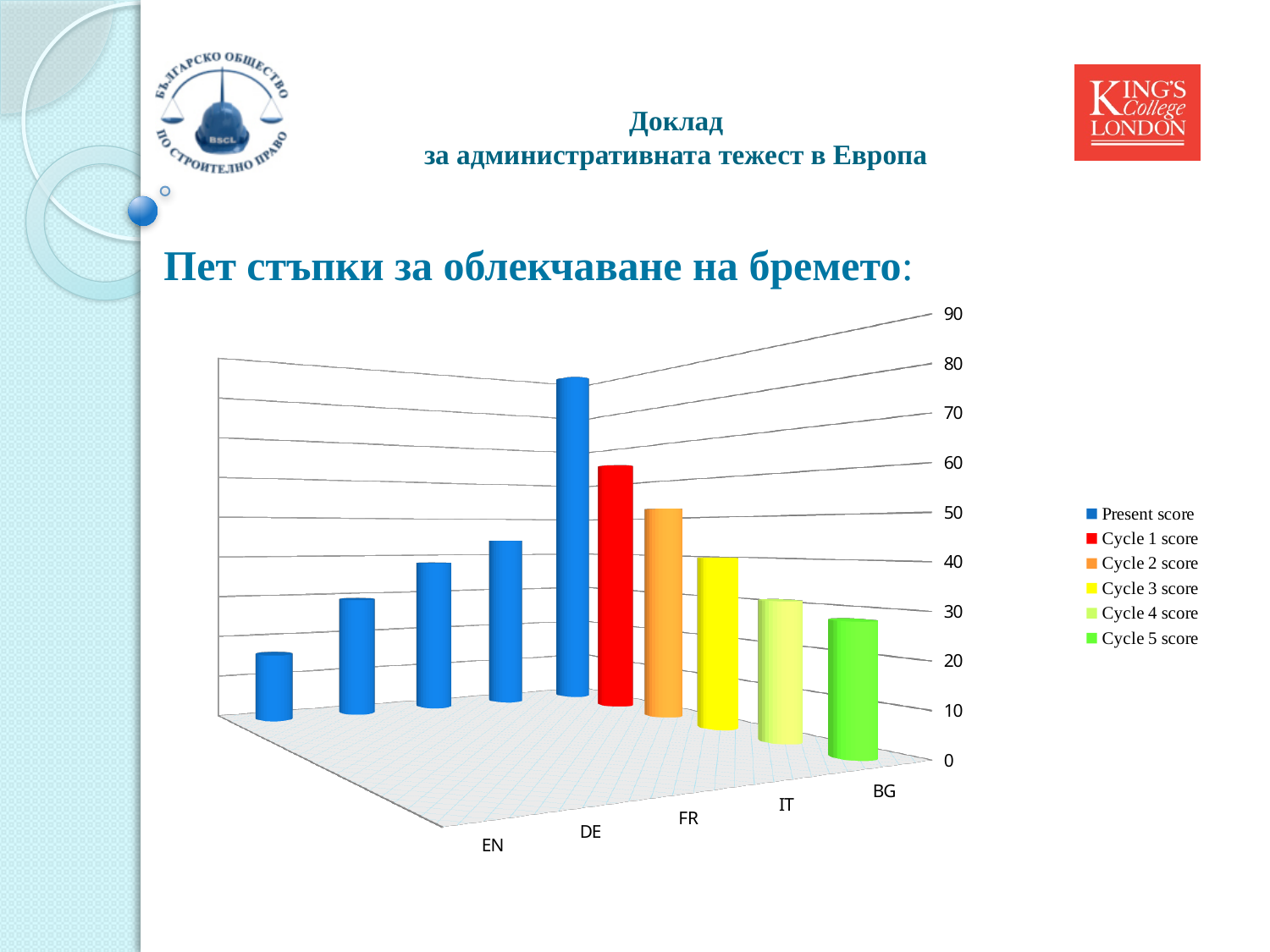
How many series does the legend list? 6 How many country labels are shown along the x axis of the chart? 5 Which is larger, the red Cycle 1 score bar or the green Cycle 5 score bar? Cycle 1 score What kind of chart is shown on the slide? bar chart Which series does the tallest bar in the chart belong to? Present score Is the value of the tallest bar in the chart greater or less than 50? greater Which is larger, the tallest blue bar or the yellow Cycle 3 score bar? the tallest blue bar Is the value of the shortest bar in the chart greater or less than 40? less What colour represents the Cycle 1 score series in the chart? red Is the value of the green Cycle 5 score bar greater or less than 50? less What is the first entry listed in the chart legend? Present score